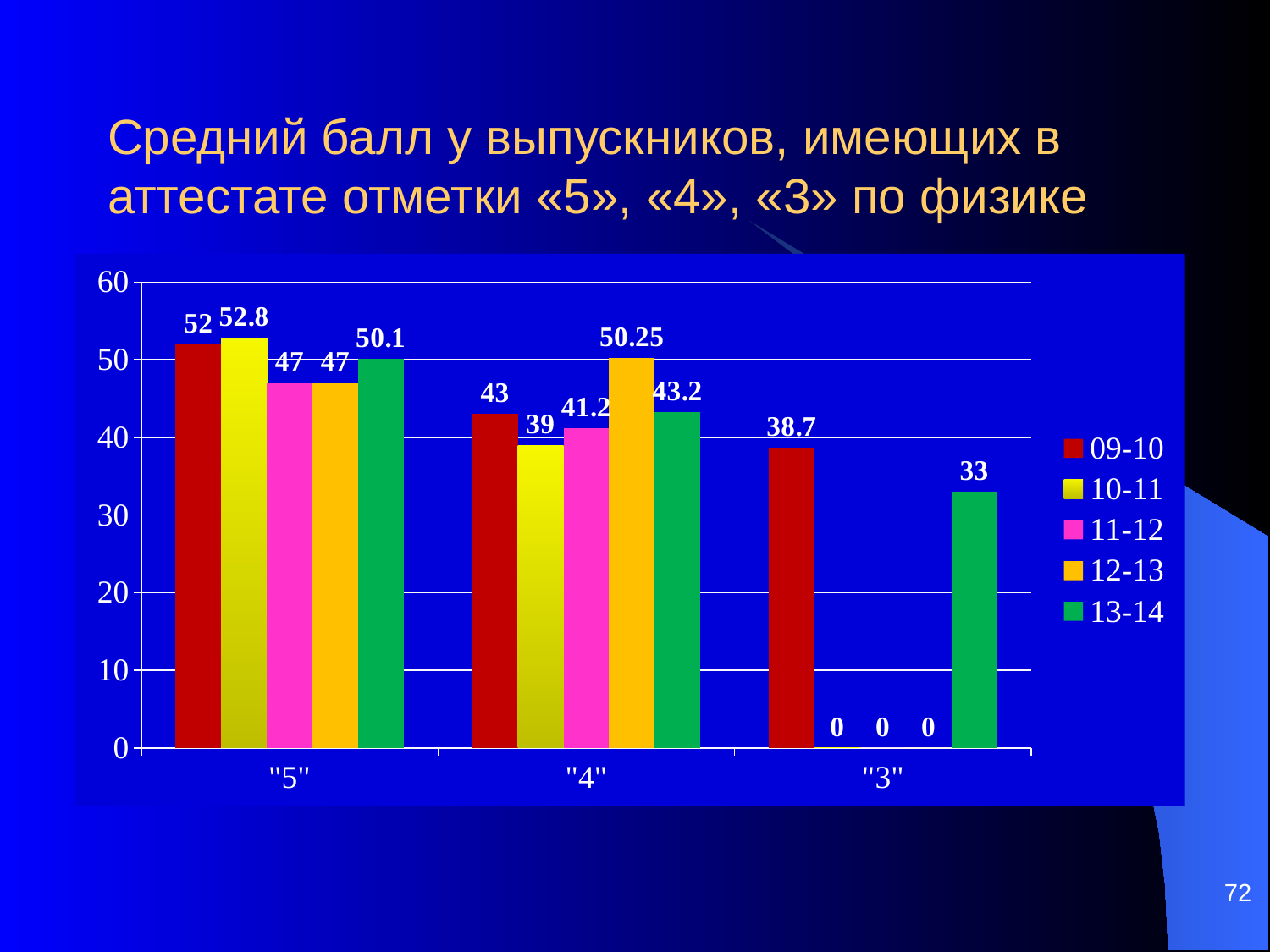
What is the value for the 13-14 series in the "5" category? 50.1 Is the value for 13-14 in the "4" category greater or less than 40? greater How many series have a value of 0 in the "3" category? 3 Which series has the highest value in the "5" category? 10-11 Which series has the lowest value in the "4" category? 10-11 What is the value for the 12-13 series in the "4" category? 50.25 Which is larger in the "3" category: the 09-10 value or the 13-14 value? 09-10 What is the difference between the 12-13 and 10-11 values in the "4" category? 11.25 What kind of chart is shown on the slide? bar chart How many series does the legend list? 5 What is the value for the 09-10 series in the "3" category? 38.7 How many categories are shown on the x axis? 3